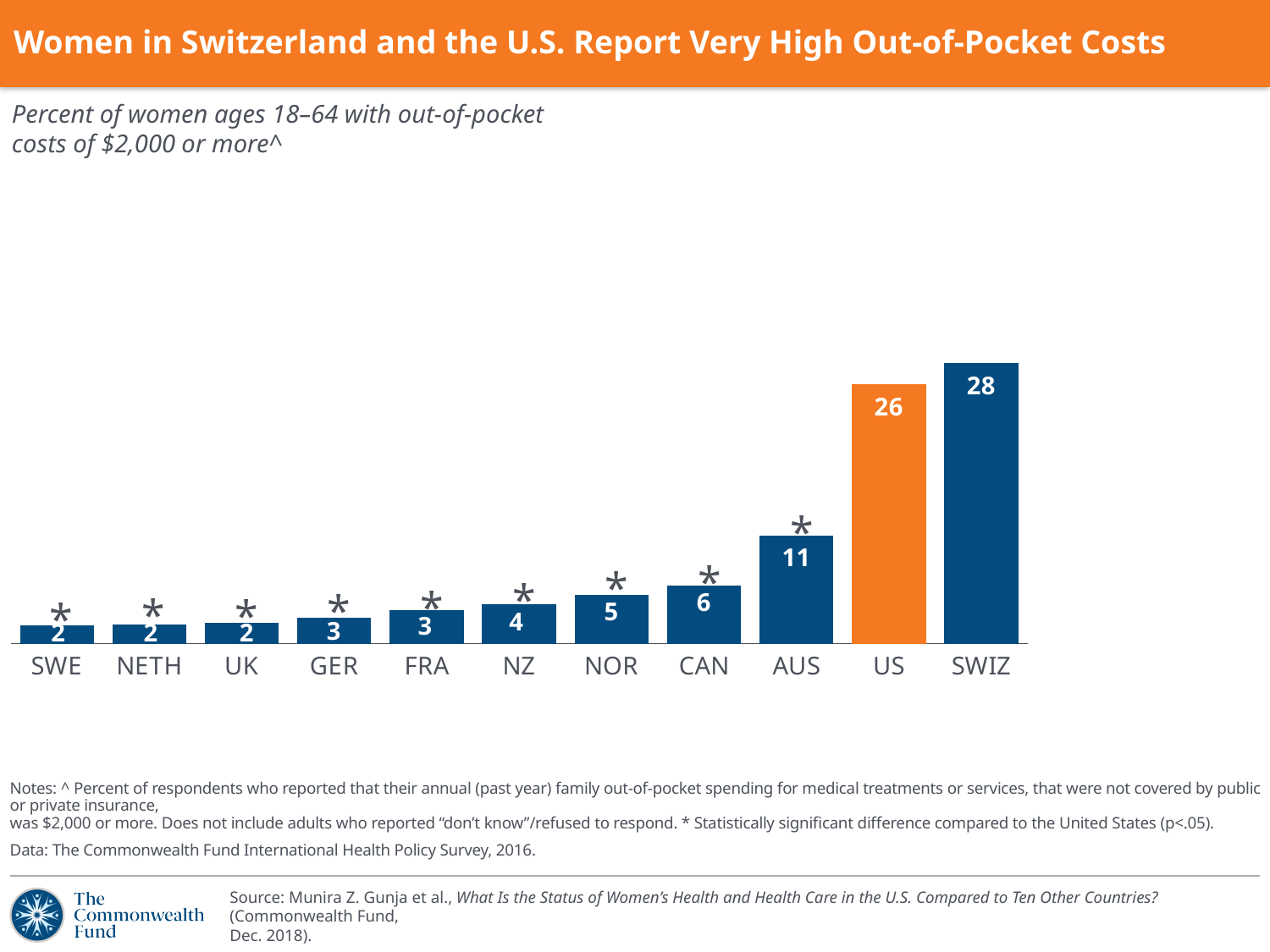
Which is larger, the value for NOR or the value for NZ? NOR What is the value for SWIZ? 28 What is the value for AUS? 11 Which country has the highest value? SWIZ What is the difference between the values for the US and AUS? 15 What kind of chart is shown on the slide? bar chart What is the value for the US? 26 Do the values rise or fall from left to right along the x axis? rise Which country's bar is coloured orange? US What is the difference between the values for SWIZ and the US? 2 What is the value for CAN? 6 How many countries are shown in the chart? 11